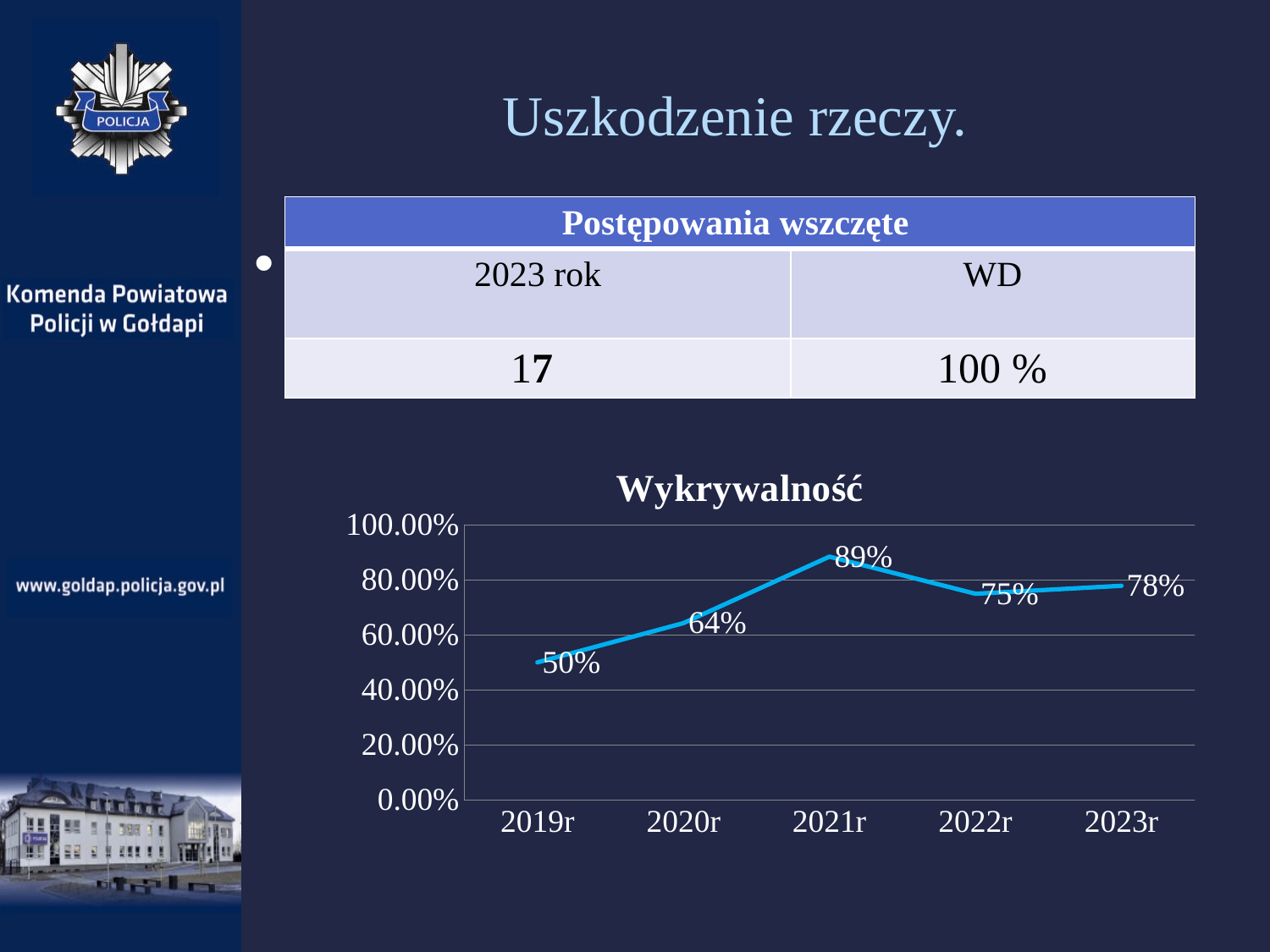
What is the detection rate (Wykrywalność) for 2021r? 89% How many years are plotted in the Wykrywalność chart? 5 Which year has the lowest detection rate in the Wykrywalność chart? 2019r What is the title of the chart on the slide? Wykrywalność Is the detection rate for 2020r greater or less than 60.00%? greater Which year has a higher detection rate, 2020r or 2022r? 2022r What is the difference between the detection rate in 2021r and 2019r? 39% What is the difference between the detection rate in 2023r and 2022r? 3% Which year has the highest detection rate in the Wykrywalność chart? 2021r What is the detection rate (Wykrywalność) for 2019r? 50% What kind of chart is the Wykrywalność chart? line chart What is the detection rate (Wykrywalność) for 2023r? 78%